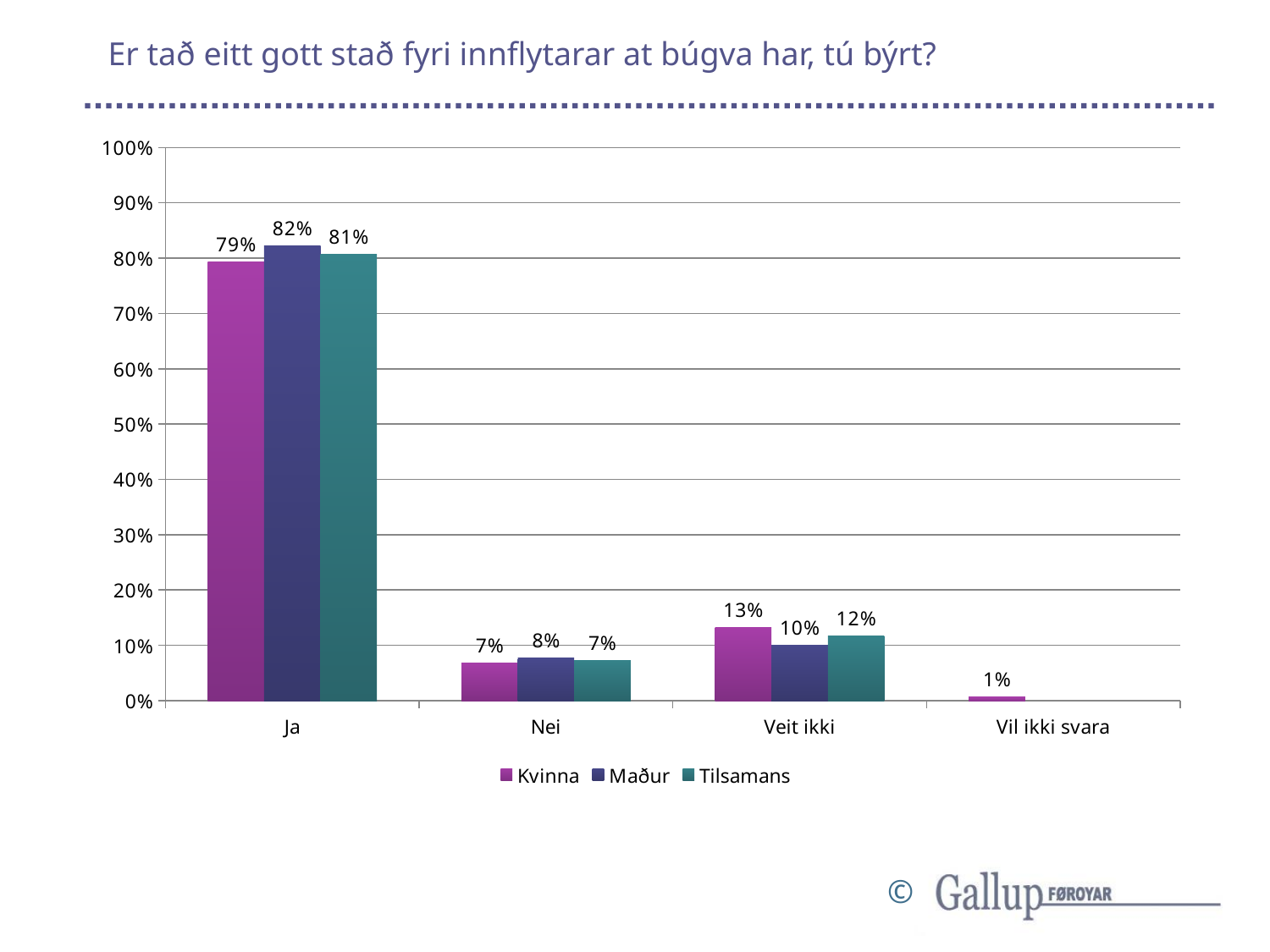
What is the difference between the Maður and Kvinna values in the Ja category? 3% What kind of chart is shown on the slide? Bar chart Which category has the lowest value for Kvinna? Vil ikki svara Which category has the highest value for Tilsamans? Ja What is the value for Kvinna in the Vil ikki svara category? 1% What is the value for Kvinna in the Ja category? 79% What is the value for Maður in the Ja category? 82% How many categories are shown on the x axis? 4 What is the value for Tilsamans in the Veit ikki category? 12% Is the value for Tilsamans in the Ja category greater or less than 70%? greater How many series does the legend list? 3 In the Veit ikki category, which is larger: Kvinna or Maður? Kvinna